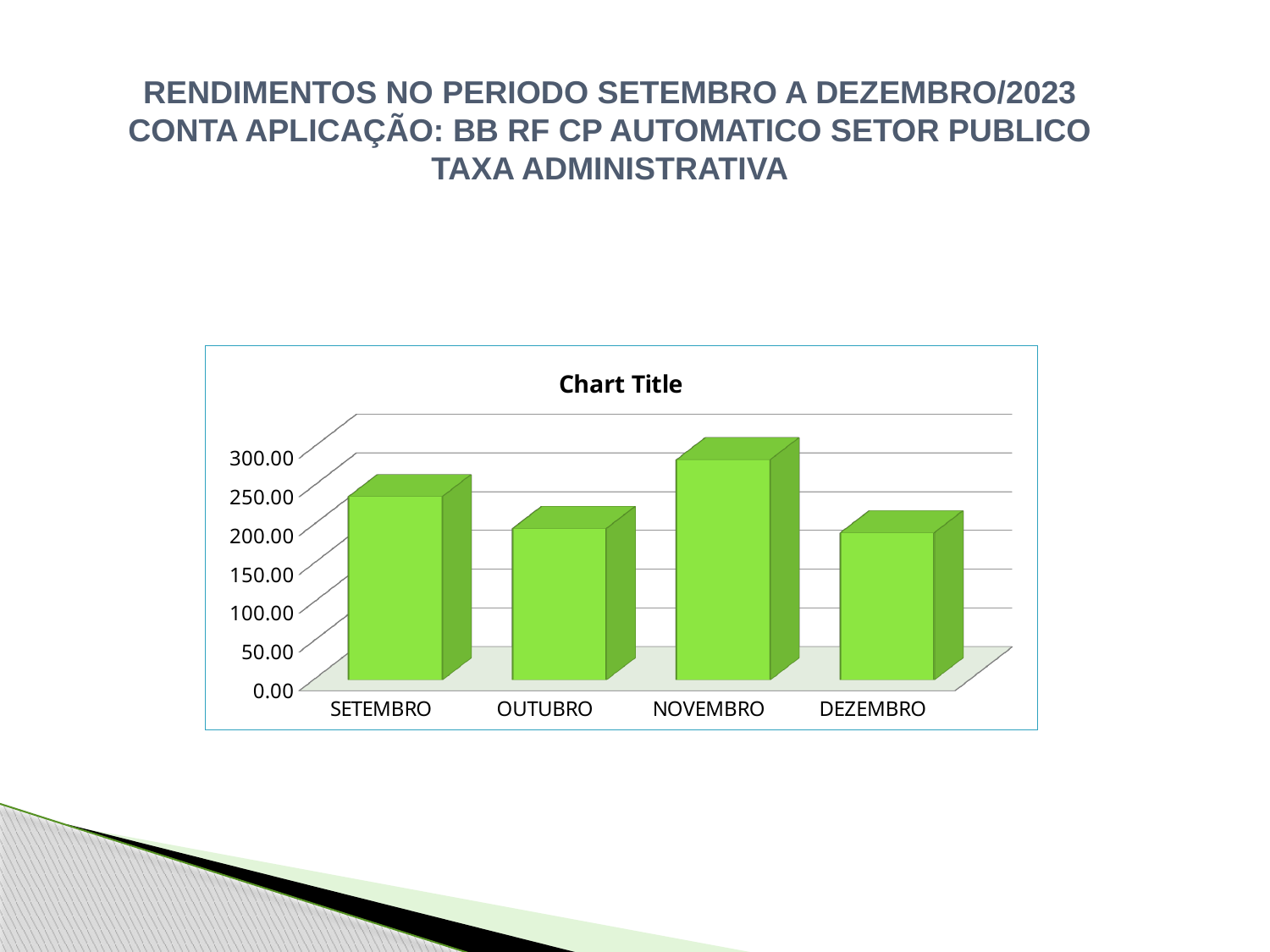
What is the title printed above the chart? Chart Title Which is larger, the value for NOVEMBRO or the value for DEZEMBRO? NOVEMBRO What kind of chart is shown on the slide? bar chart Which is larger, the value for SETEMBRO or the value for OUTUBRO? SETEMBRO Is the value for DEZEMBRO greater or less than 150? greater Is the value for SETEMBRO greater or less than 200? greater How many categories are shown on the x axis of the chart? 4 Is the value for NOVEMBRO greater or less than 250? greater Which month has the highest value in the chart? NOVEMBRO Which is larger, the value for NOVEMBRO or the value for SETEMBRO? NOVEMBRO What is the highest value labelled on the vertical axis of the chart? 300.00